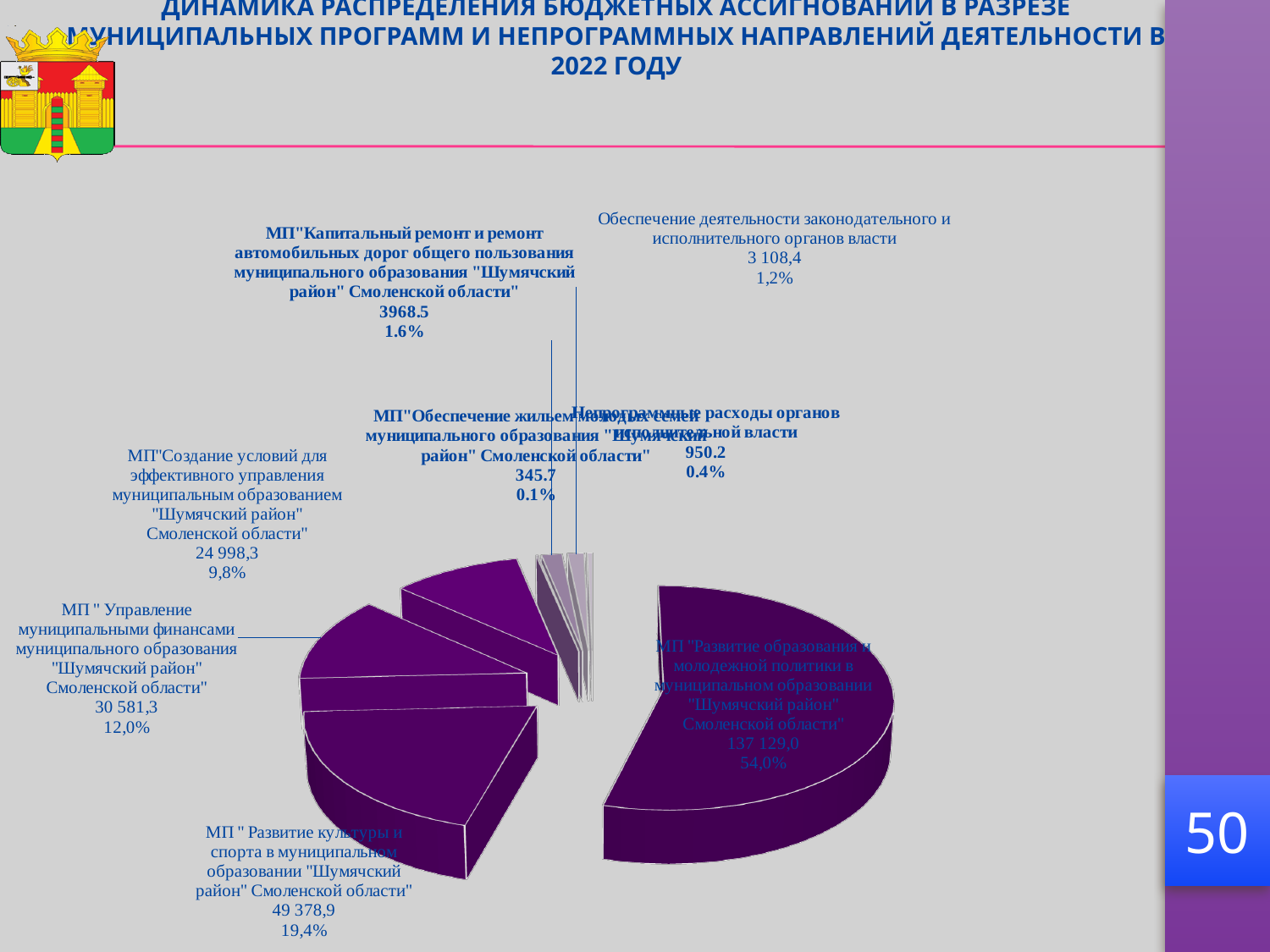
What share of the pie does Непрограммные расходы органов исполнительной власти have? 0.4% What value is shown for МП "Создание условий для эффективного управления муниципальным образованием "Шумячский район" Смоленской области"? 24 998,3 What value is shown for МП "Развитие культуры и спорта в муниципальном образовании "Шумячский район" Смоленской области"? 49 378,9 What value is shown for Обеспечение деятельности законодательного и исполнительного органов власти? 3 108,4 Which category has the largest share of the pie? МП "Развитие образования и молодежной политики в муниципальном образовании "Шумячский район" Смоленской области" Which is larger: the value for МП "Управление муниципальными финансами..." or the value for МП "Создание условий для эффективного управления..."? МП "Управление муниципальными финансами..." What is the difference in percentage share between МП "Развитие культуры и спорта..." (19,4%) and МП "Управление муниципальными финансами..." (12,0%)? 7,4% What share of the pie does МП "Капитальный ремонт и ремонт автомобильных дорог общего пользования муниципального образования "Шумячский район" Смоленской области" have? 1.6% Which category has the smallest share of the pie? МП "Обеспечение жильем молодых семей муниципального образования "Шумячский район" Смоленской области" How many slices does the pie chart have? 8 What kind of chart is shown on the slide? pie chart What share of the pie does МП "Управление муниципальными финансами муниципального образования "Шумячский район" Смоленской области" have? 12,0%